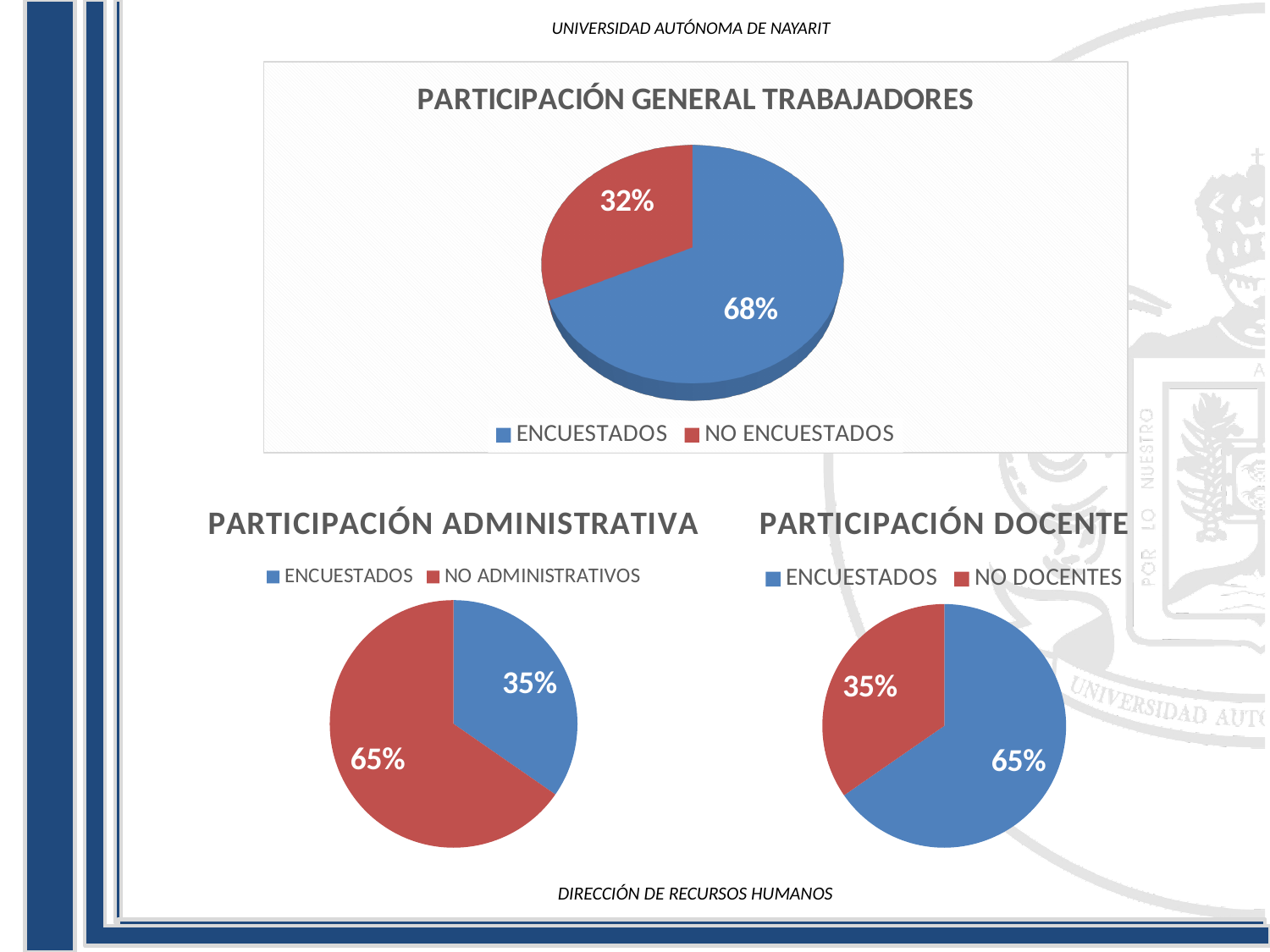
In the 'PARTICIPACIÓN ADMINISTRATIVA' chart, which slice is the smallest? ENCUESTADOS What kind of chart is 'PARTICIPACIÓN DOCENTE'? Pie chart How many entries does the legend of the 'PARTICIPACIÓN ADMINISTRATIVA' chart list? 2 In the 'PARTICIPACIÓN GENERAL TRABAJADORES' chart, what share is labelled for NO ENCUESTADOS? 32% In the 'PARTICIPACIÓN GENERAL TRABAJADORES' chart, what share is labelled for ENCUESTADOS? 68% In the 'PARTICIPACIÓN DOCENTE' chart, which is larger, ENCUESTADOS or NO DOCENTES? ENCUESTADOS In the 'PARTICIPACIÓN DOCENTE' chart, what share is labelled for NO DOCENTES? 35% In the 'PARTICIPACIÓN ADMINISTRATIVA' chart, what share is labelled for NO ADMINISTRATIVOS? 65% In the 'PARTICIPACIÓN GENERAL TRABAJADORES' chart, which slice is the largest? ENCUESTADOS In the 'PARTICIPACIÓN GENERAL TRABAJADORES' chart, what is the difference between the ENCUESTADOS and NO ENCUESTADOS shares? 36% In the 'PARTICIPACIÓN DOCENTE' chart, what share is labelled for ENCUESTADOS? 65% In the 'PARTICIPACIÓN ADMINISTRATIVA' chart, what share is labelled for ENCUESTADOS? 35%